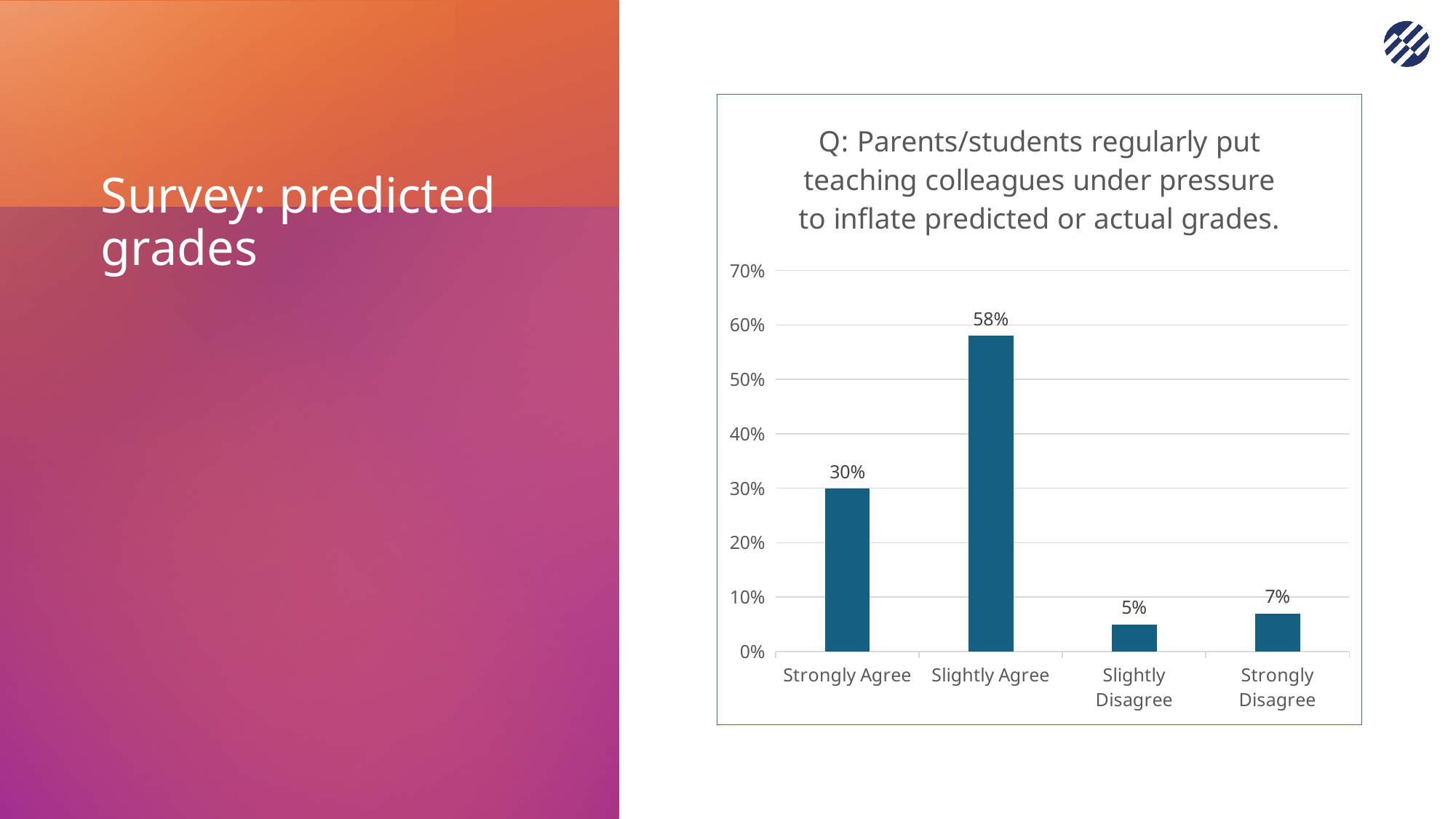
What type of chart is shown on the slide? bar chart What percentage of respondents chose Strongly Agree? 30% What is the highest value shown on the vertical axis? 70% Which response category has the lowest percentage? Slightly Disagree What is the difference in percentage points between Slightly Agree and Strongly Agree? 28 How many response categories are shown on the x axis? 4 Is the value for Slightly Agree greater or less than 50%? greater What percentage of respondents chose Slightly Agree? 58% Which response category has the highest percentage? Slightly Agree What percentage of respondents chose Slightly Disagree? 5% What percentage of respondents chose Strongly Disagree? 7% Which is larger, the value for Strongly Disagree or the value for Slightly Disagree? Strongly Disagree